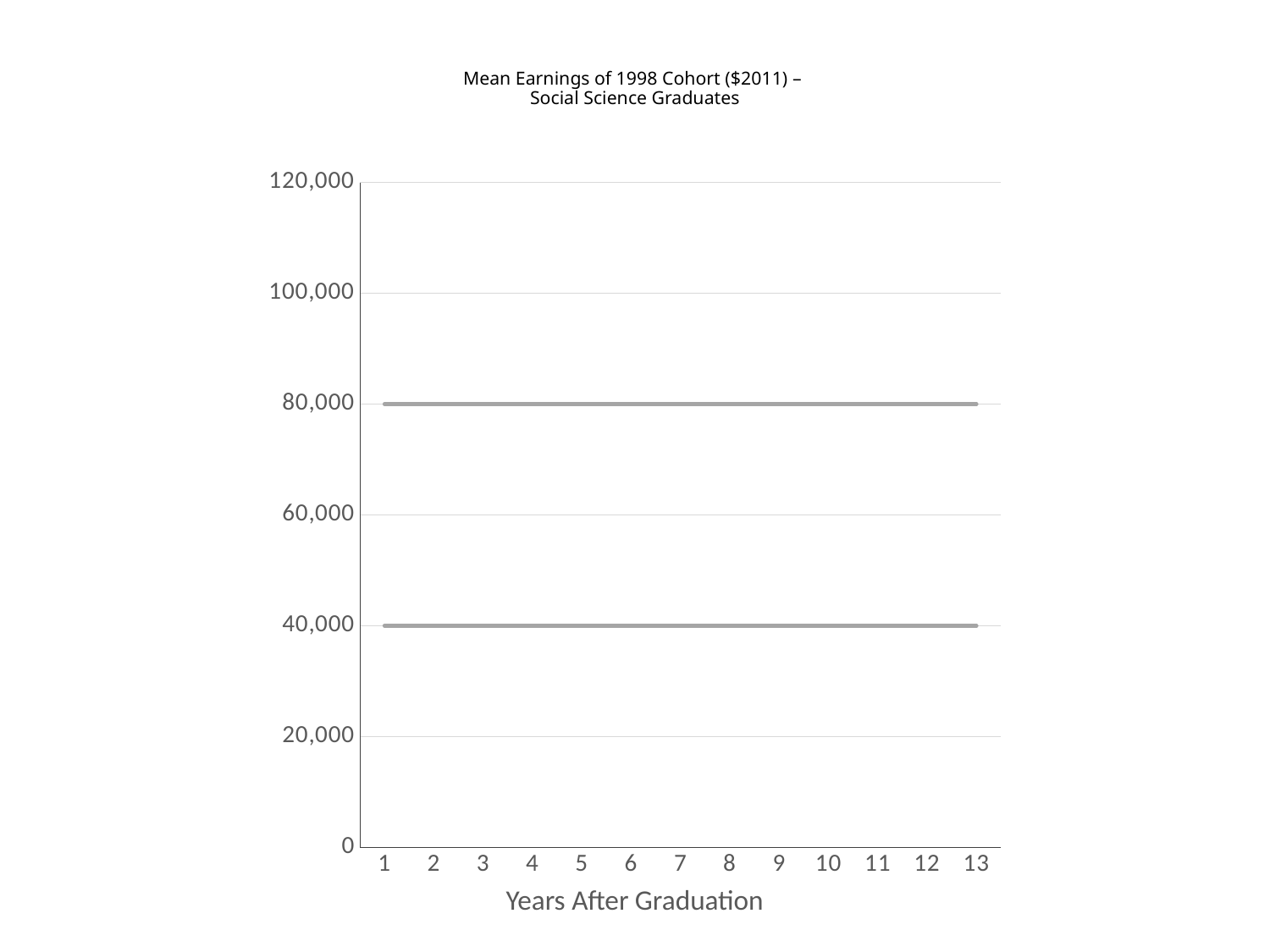
Is the value of the upper line at year 5 greater or less than 60,000? greater Is the value of the lower line at year 10 greater or less than 60,000? less What is the title of the chart? Mean Earnings of 1998 Cohort ($2011) – Social Science Graduates What kind of chart is shown on the slide? line chart How many years after graduation are shown on the x axis? 13 What is the label of the x axis? Years After Graduation At what value does the lower line sit across all years? 40,000 What is the difference between the upper line and the lower line? 40,000 Do the values of the lower line rise, fall, or stay flat from year 1 to year 13? stay flat How many lines are plotted on the chart? 2 At what value does the upper line sit across all years? 80,000 Do the values of the upper line rise, fall, or stay flat from year 1 to year 13? stay flat